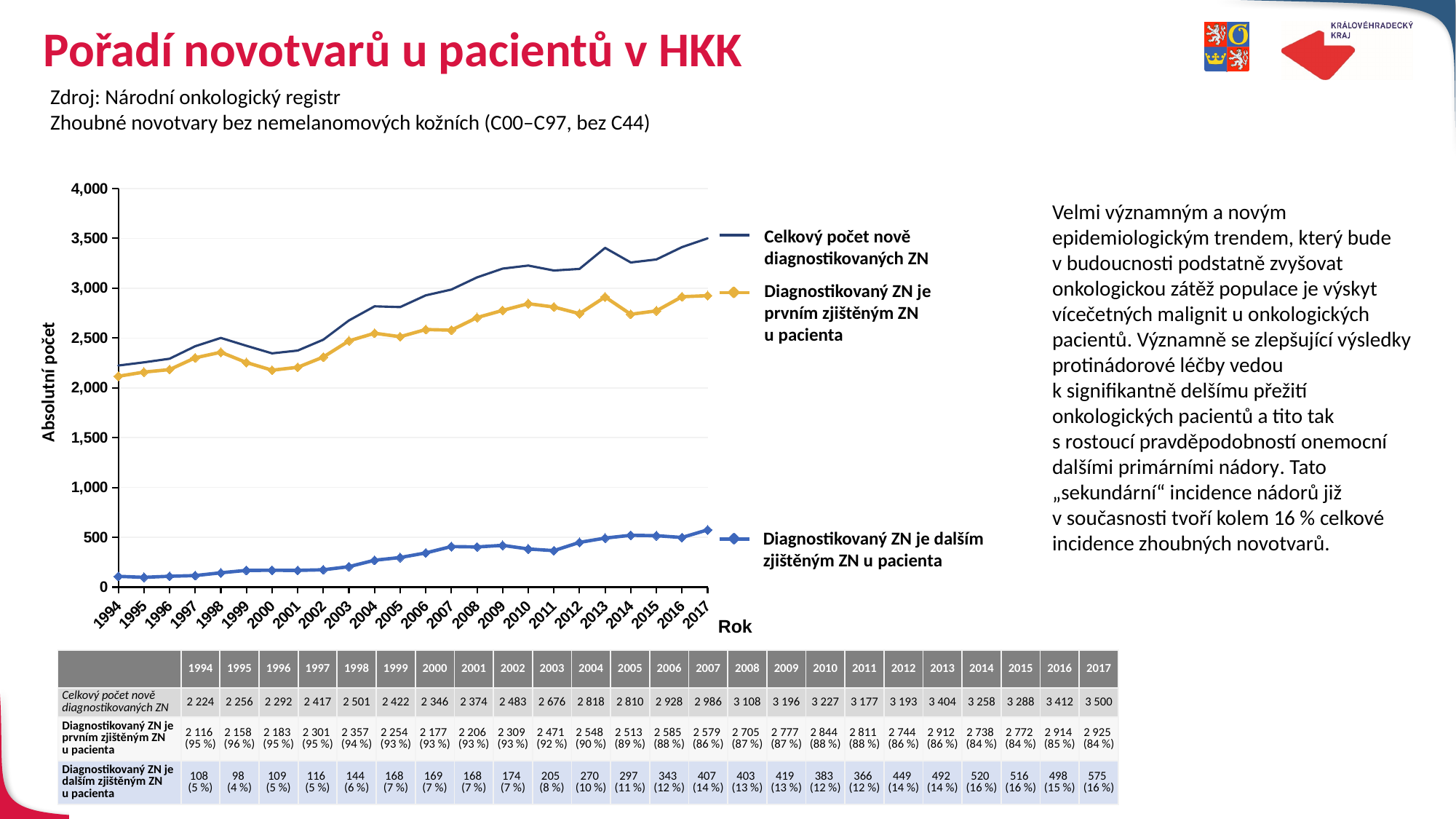
Does 'Diagnostikovaný ZN je dalším zjištěným ZN u pacienta' generally rise or fall from 1994 to 2017? rise In which year is 'Diagnostikovaný ZN je dalším zjištěným ZN u pacienta' lowest? 1995 What kind of chart is shown on the slide? line chart Is the value for 'Diagnostikovaný ZN je dalším zjištěným ZN u pacienta' in 2005 greater or less than 500? less What is the value of 'Diagnostikovaný ZN je dalším zjištěným ZN u pacienta' in 1994? 108 How many series does the chart's legend list? 3 In which year is 'Celkový počet nově diagnostikovaných ZN' highest? 2017 What is the value of 'Diagnostikovaný ZN je prvním zjištěným ZN u pacienta' in 2017? 2 925 What is the difference between 'Celkový počet nově diagnostikovaných ZN' in 2017 and in 1994? 1 276 How many years are plotted along the x axis of the chart? 24 Which is larger in 2013: 'Celkový počet nově diagnostikovaných ZN' or 'Diagnostikovaný ZN je prvním zjištěným ZN u pacienta'? Celkový počet nově diagnostikovaných ZN What is the value of 'Celkový počet nově diagnostikovaných ZN' in 2017? 3 500